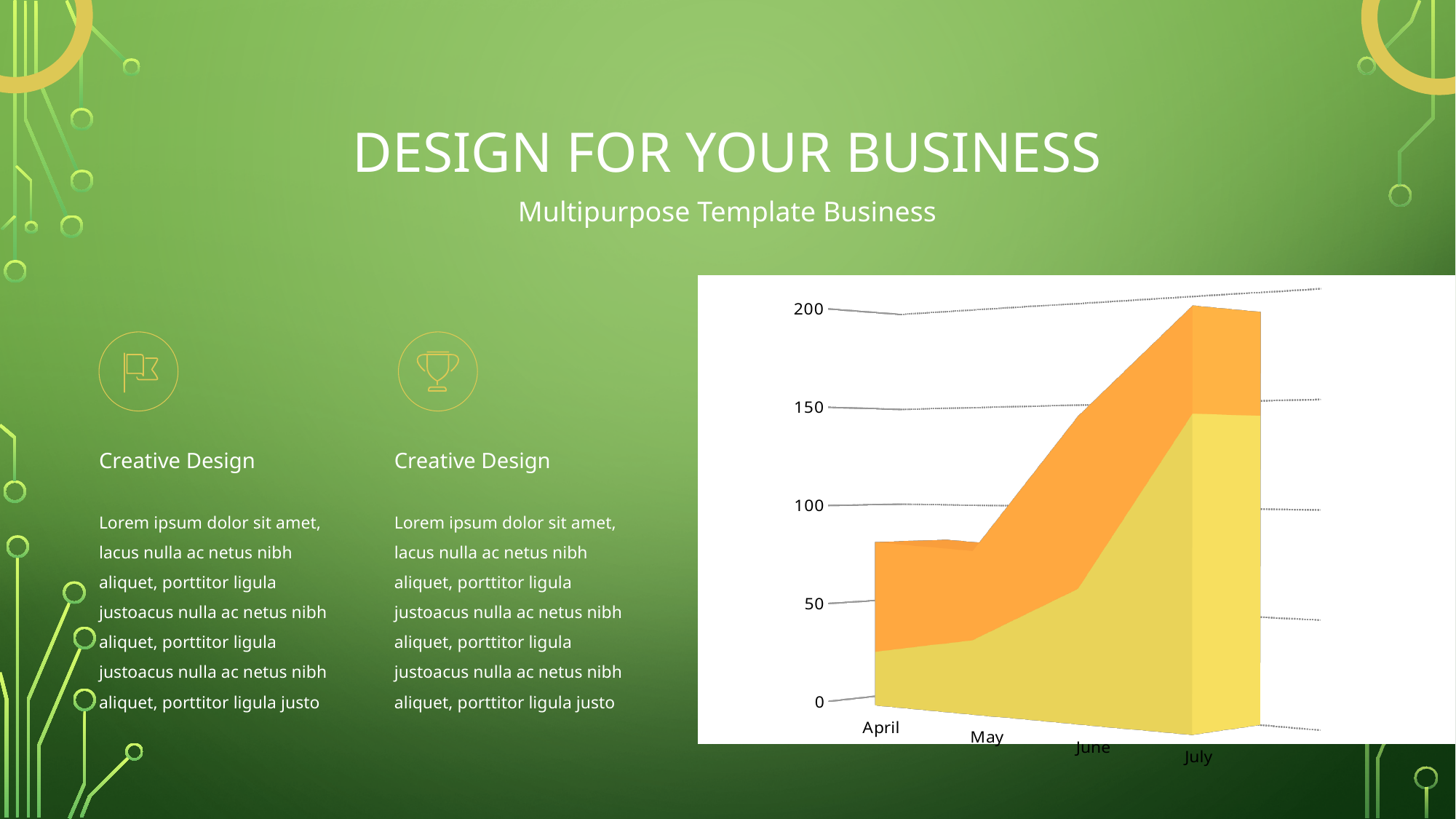
Is the stacked total for April greater or less than 50? greater Is the value of the lower (yellow) series for April greater or less than 50? less Is the value of the lower (yellow) series for May greater or less than 50? less What is the first category label on the x axis of the chart? April Do the values in the chart rise or fall from April to July? rise How many categories are shown on the x axis of the chart? 4 Which month has the highest stacked total in the chart? July What kind of chart is shown on the slide? area chart